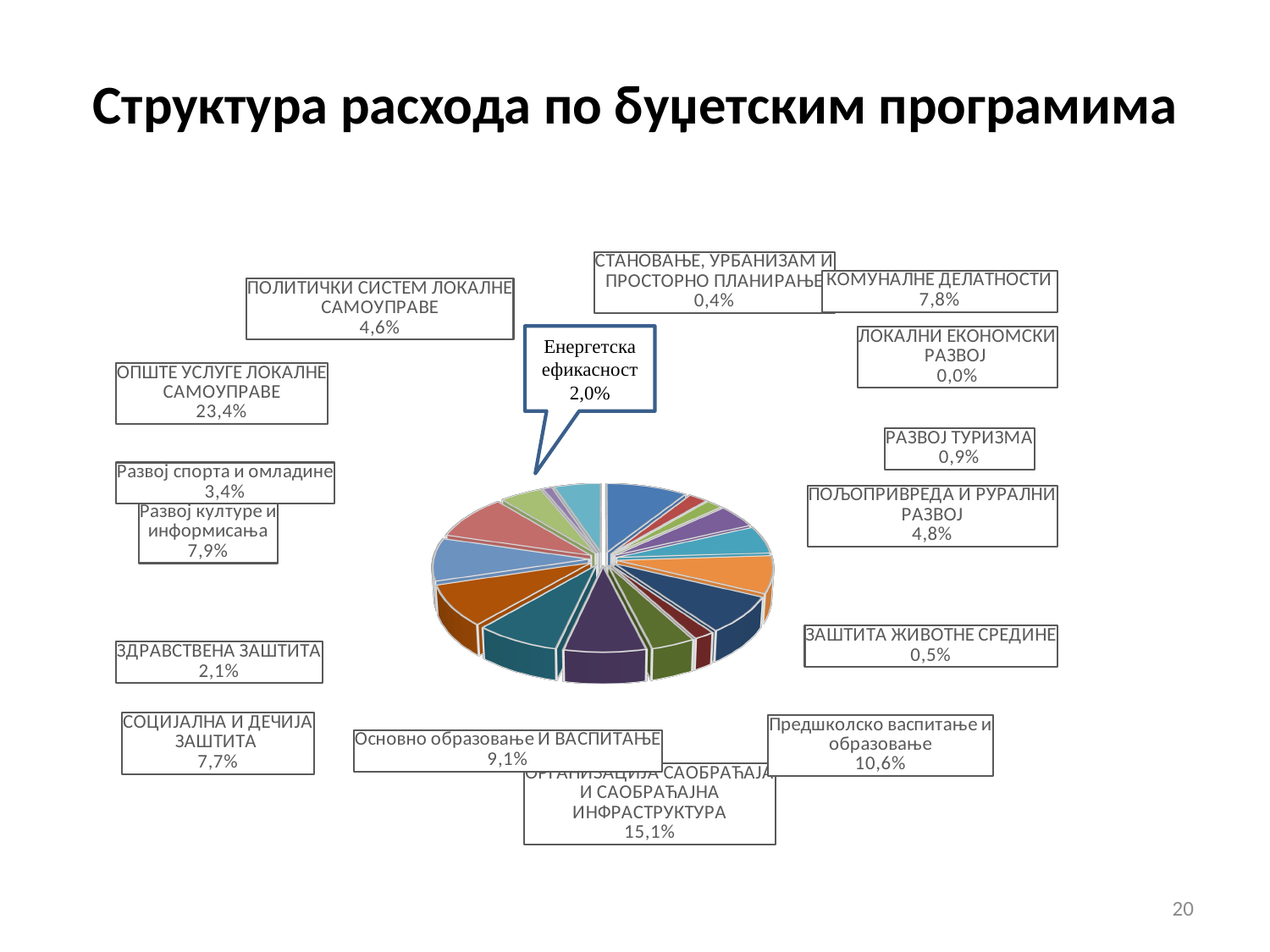
What is the difference in percentage points between ОПШТЕ УСЛУГЕ ЛОКАЛНЕ САМОУПРАВЕ and ОРГАНИЗАЦИЈА САОБРАЋАЈА И САОБРАЋАЈНА ИНФРАСТРУКТУРА? 8,3 percentage points Which budget programme has the smallest share of the pie? ЛОКАЛНИ ЕКОНОМСКИ РАЗВОЈ Which has a larger share: Основно образовање И ВАСПИТАЊЕ or СОЦИЈАЛНА И ДЕЧИЈА ЗАШТИТА? Основно образовање И ВАСПИТАЊЕ What is the value shown for Предшколско васпитање и образовање? 10,6% What kind of chart is shown on the slide? Pie chart How many budget programmes are labelled in the pie chart? 16 Which budget programme has the largest share of the pie? ОПШТЕ УСЛУГЕ ЛОКАЛНЕ САМОУПРАВЕ What share is shown for ОРГАНИЗАЦИЈА САОБРАЋАЈА И САОБРАЋАЈНА ИНФРАСТРУКТУРА? 15,1% What is the title of the slide's chart? Структура расхода по буџетским програмима Which has a larger share: ПОЉОПРИВРЕДА И РУРАЛНИ РАЗВОЈ or РАЗВОЈ ТУРИЗМА? ПОЉОПРИВРЕДА И РУРАЛНИ РАЗВОЈ What percentage is labelled for Енергетска ефикасност? 2,0% What share does ОПШТЕ УСЛУГЕ ЛОКАЛНЕ САМОУПРАВЕ have in the pie chart? 23,4%